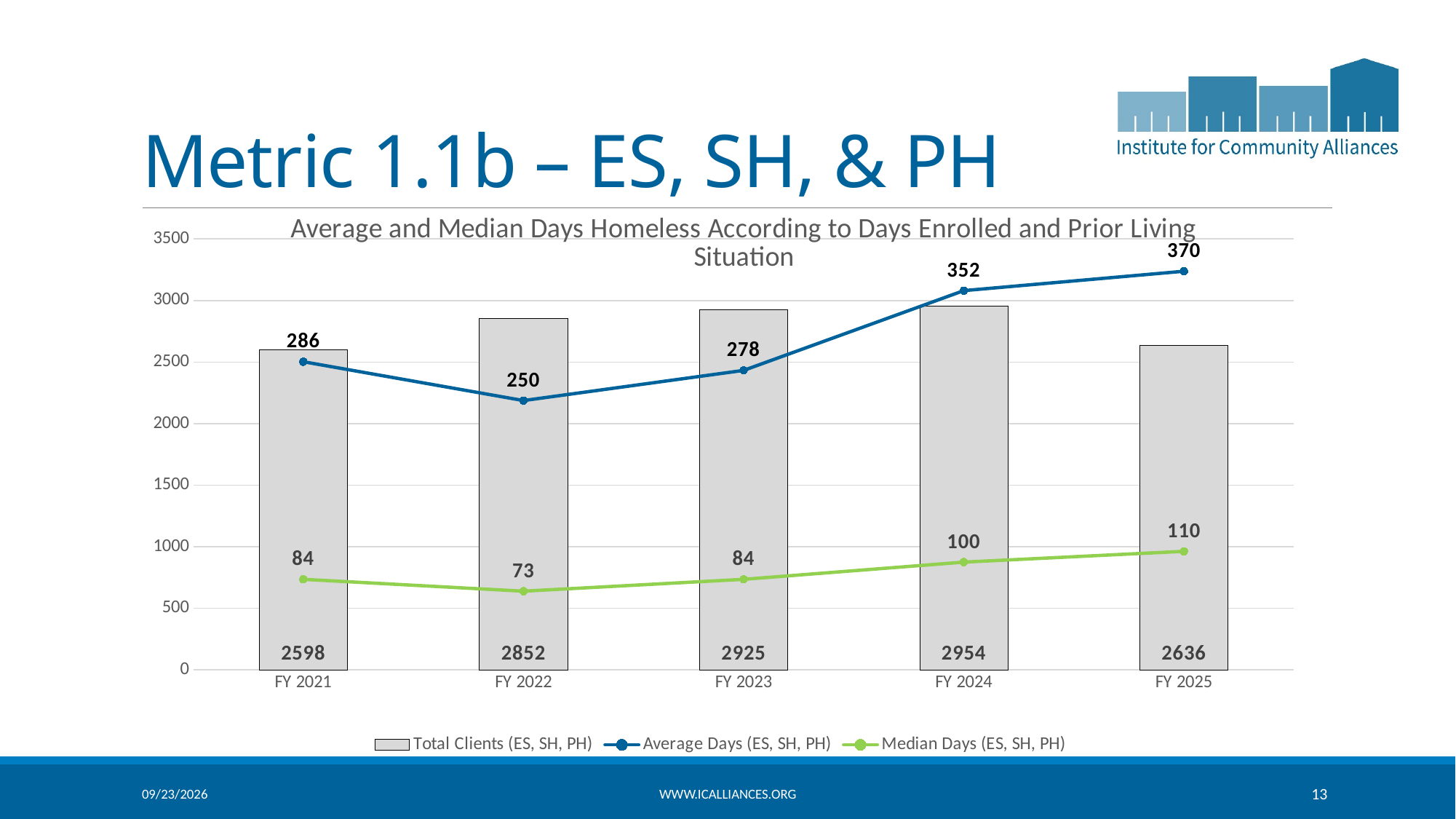
How many fiscal years are shown on the x axis? 5 How many series does the legend list? 3 Which is larger: Total Clients (ES, SH, PH) in FY 2021 or in FY 2025? FY 2025 Which fiscal year has the highest Total Clients (ES, SH, PH)? FY 2024 What is the difference in Average Days (ES, SH, PH) between FY 2025 and FY 2024? 18 Does Median Days (ES, SH, PH) rise or fall from FY 2022 to FY 2025? Rise What is the value of Total Clients (ES, SH, PH) for FY 2023? 2925 Which fiscal year has the lowest Median Days (ES, SH, PH)? FY 2022 What is the title of the chart? Average and Median Days Homeless According to Days Enrolled and Prior Living Situation What kind of chart is used to show Total Clients (ES, SH, PH)? Bar chart What is the Median Days (ES, SH, PH) value for FY 2025? 110 What is the Average Days (ES, SH, PH) value for FY 2022? 250